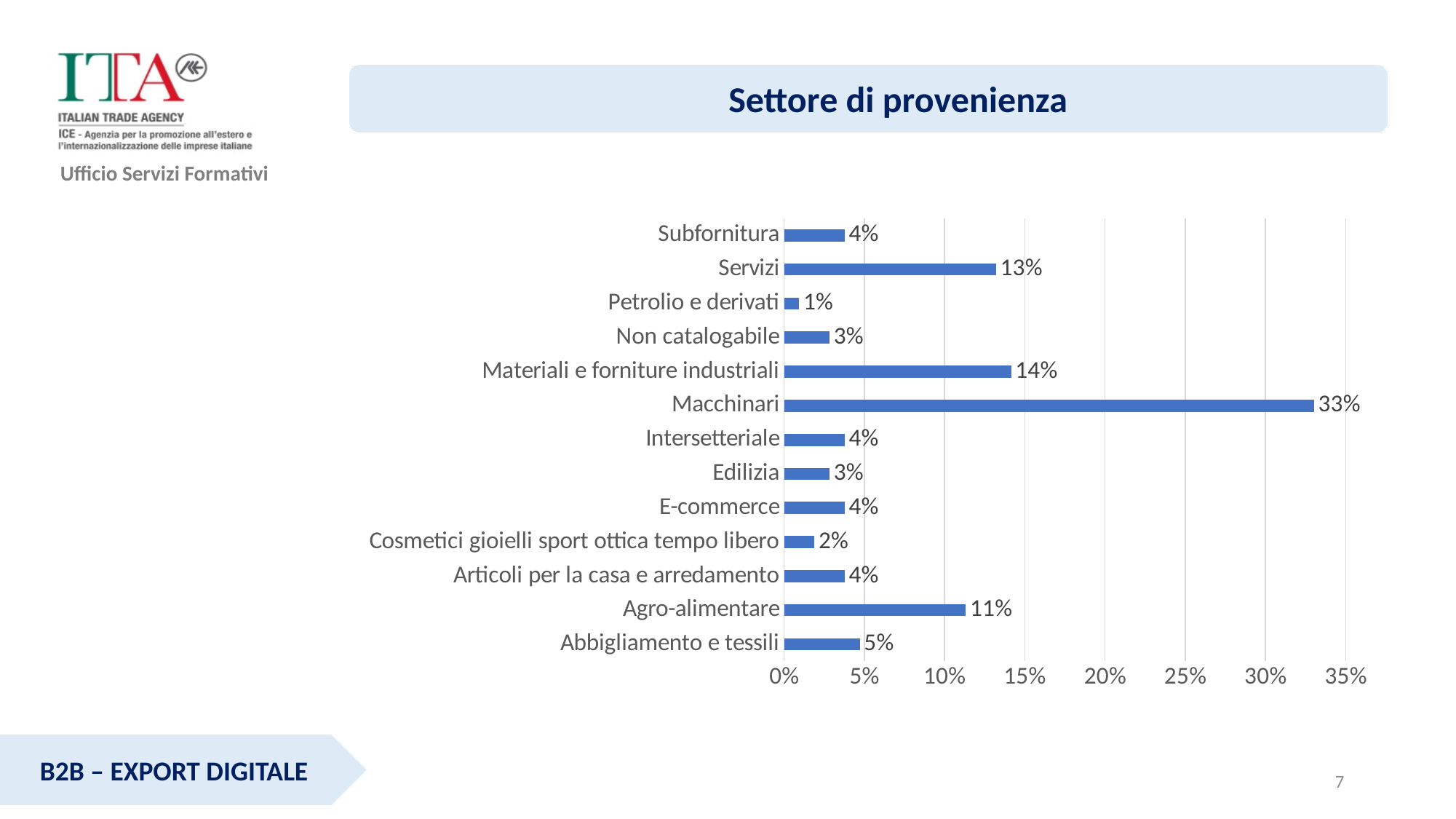
Which category has the lowest value? Petrolio e derivati How many categories are shown in the chart? 13 What is the value for Servizi? 13% What is the title of the chart? Settore di provenienza What kind of chart is shown on the slide? bar chart Which category has the highest value? Macchinari Which is larger, the value for Servizi or the value for Agro-alimentare? Servizi What is the value for Macchinari? 33% What is the value for Agro-alimentare? 11% What is the difference between the values for Macchinari and Materiali e forniture industriali? 19% Is the value for Macchinari greater or less than 30%? greater What is the value for Petrolio e derivati? 1%